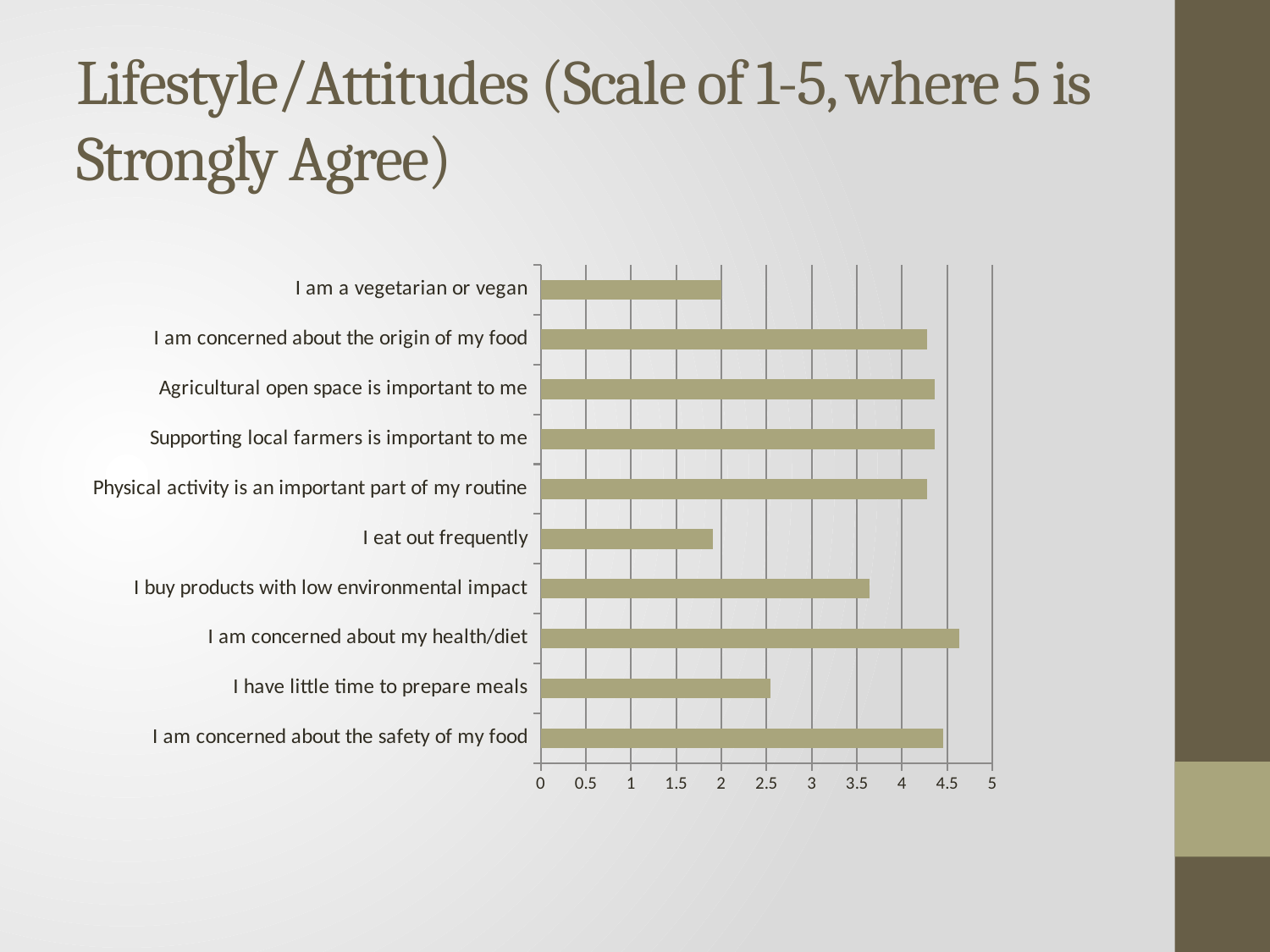
Is the value for "I have little time to prepare meals" greater or less than 3? less What kind of chart is shown on the slide? bar chart How many statements (categories) are plotted in the chart? 10 Is the value for "I am concerned about my health/diet" greater or less than 4.5? greater Is the value for "I buy products with low environmental impact" greater or less than 3.5? greater Which has a larger value: "I am concerned about my health/diet" or "I have little time to prepare meals"? I am concerned about my health/diet Which has a larger value: "I eat out frequently" or "I buy products with low environmental impact"? I buy products with low environmental impact What is the maximum value shown on the horizontal axis of the chart? 5 Which statement has the highest average score in the chart? I am concerned about my health/diet